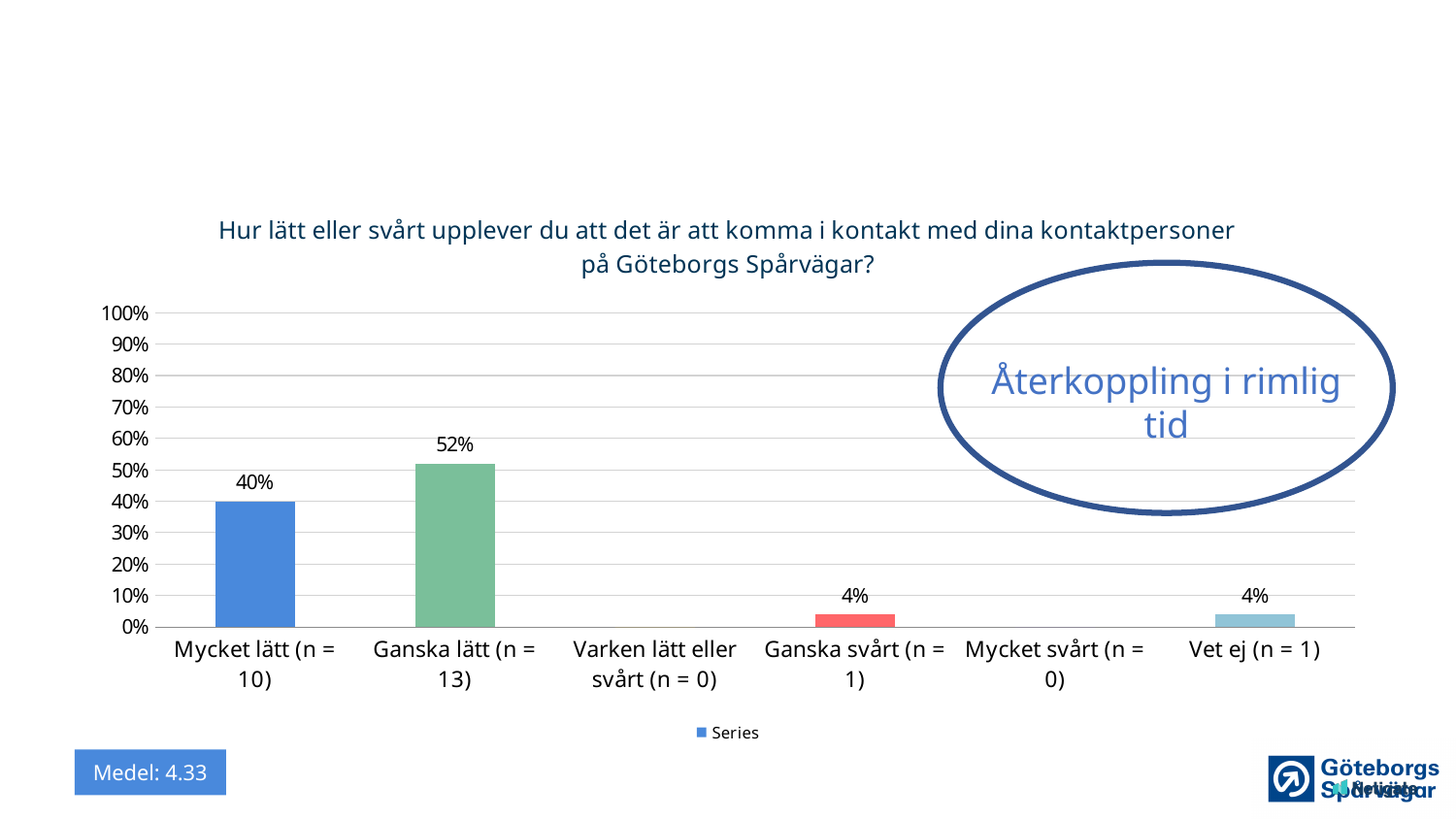
What is the value for Ganska lätt (n = 13)? 52% What is the value for Ganska svårt (n = 1)? 4% How many categories are shown on the x axis? 6 What is the difference between the values for Ganska lätt (n = 13) and Mycket lätt (n = 10)? 12% Which is larger, the value for Mycket lätt (n = 10) or the value for Ganska svårt (n = 1)? Mycket lätt (n = 10) What is the value for Mycket lätt (n = 10)? 40% How many series does the legend list? 1 What kind of chart is shown on the slide? bar chart Which category has the highest value? Ganska lätt (n = 13) What is the value for Vet ej (n = 1)? 4% What is the title of the chart? Hur lätt eller svårt upplever du att det är att komma i kontakt med dina kontaktpersoner på Göteborgs Spårvägar? Is the value for Ganska lätt (n = 13) greater or less than 50%? greater